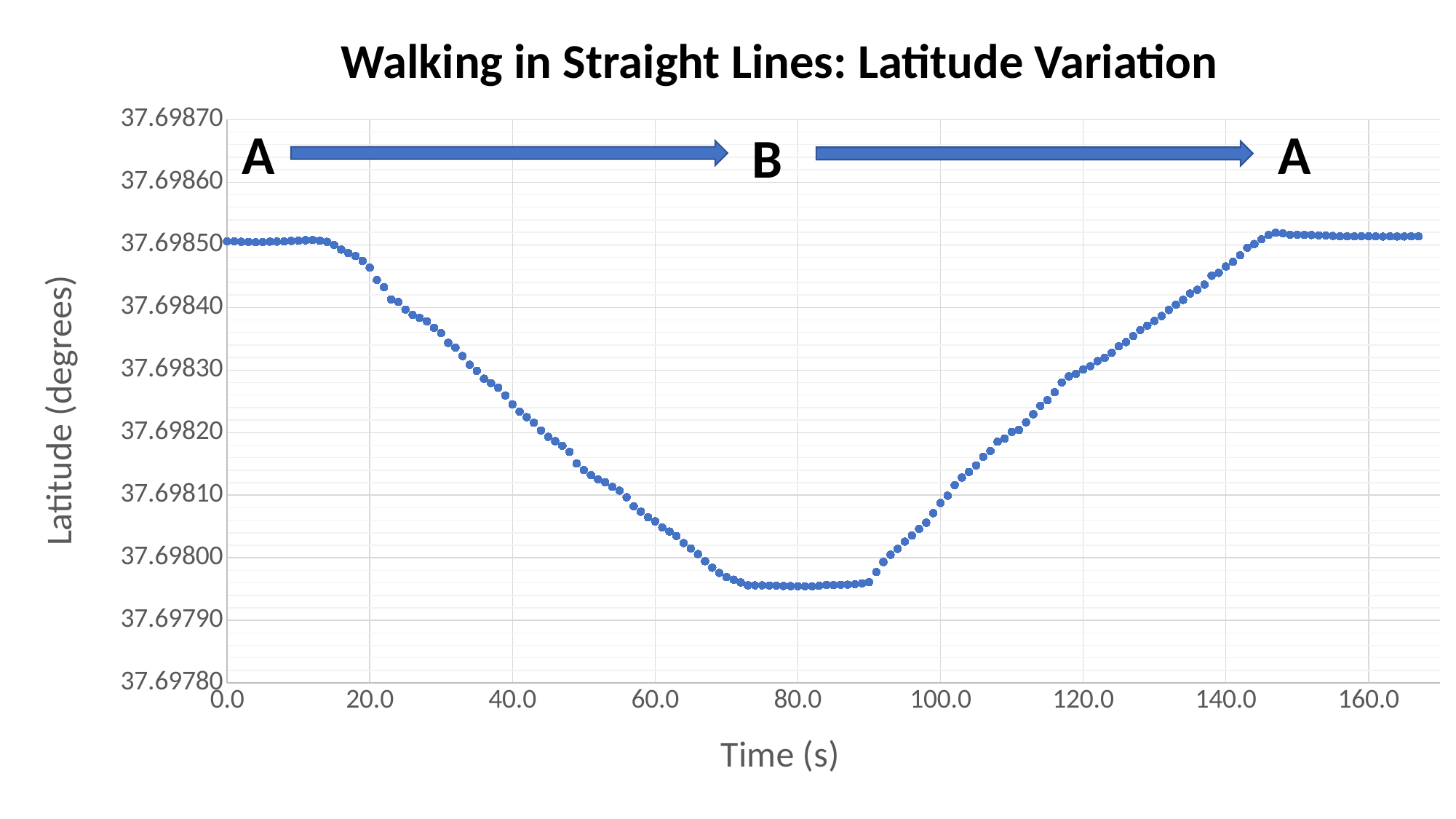
What is the title of the chart? Walking in Straight Lines: Latitude Variation Is the latitude at 140.0 s greater or less than 37.69840? greater Is the latitude at 40.0 s greater or less than the latitude at 80.0 s? greater Is the latitude at 60.0 s greater or less than 37.69800? greater Does the latitude rise or fall between 20.0 s and 70.0 s? fall Is the latitude at 80.0 s greater or less than 37.69800? less What is the label of the vertical axis? Latitude (degrees) What kind of chart is shown on the slide? scatter chart Is the latitude at 120.0 s greater or less than the latitude at 60.0 s? greater Does the latitude rise or fall between 90.0 s and 140.0 s? rise